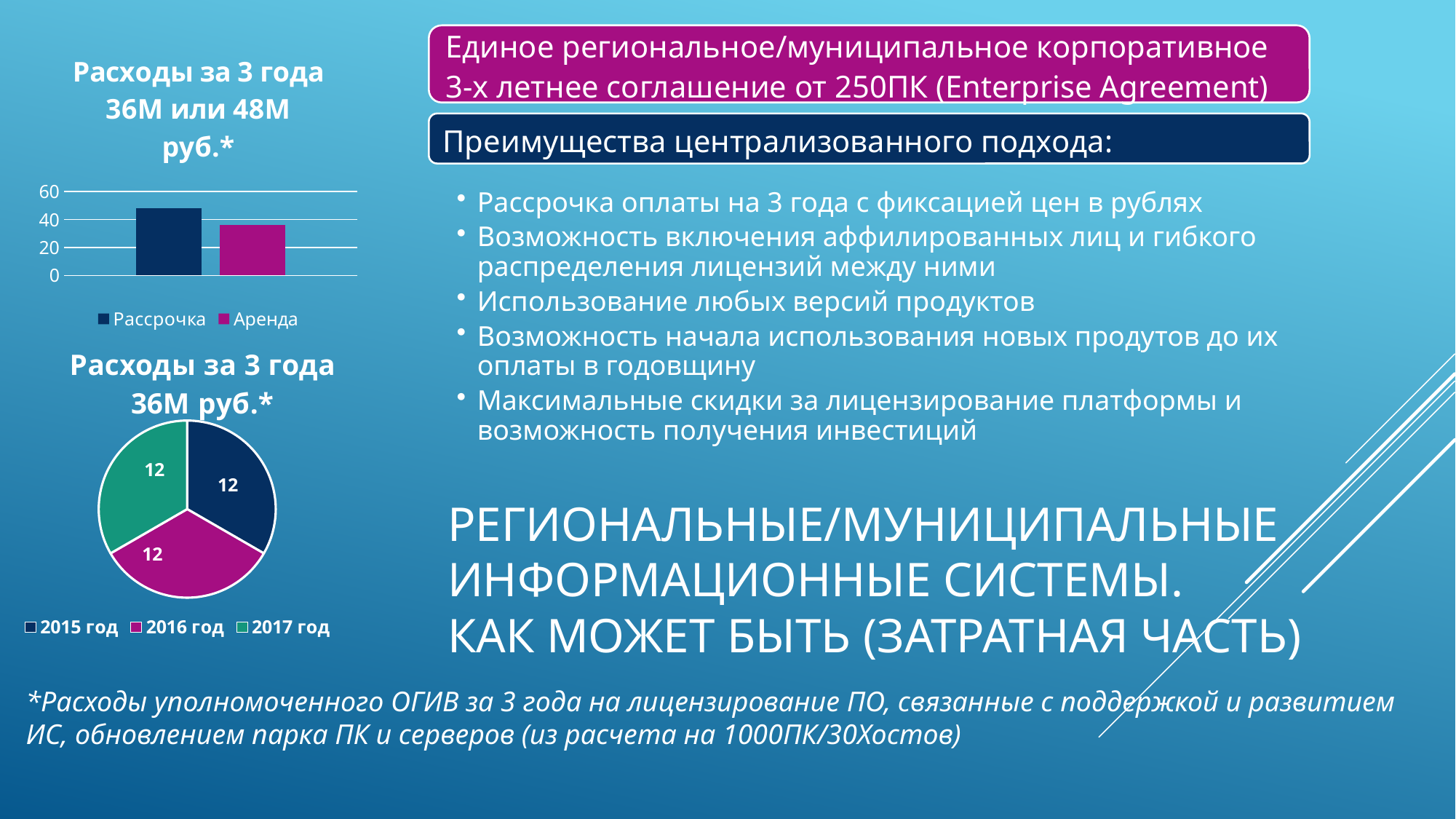
In the bar chart 'Расходы за 3 года 36М или 48М руб.*', is the value for Аренда greater or less than 40? less In the bar chart 'Расходы за 3 года 36М или 48М руб.*', is the value for Рассрочка greater or less than 40? greater In the pie chart 'Расходы за 3 года 36М руб.*', what is the value for 2016 год? 12 In the pie chart 'Расходы за 3 года 36М руб.*', what is the total of all slices? 36 What kind of chart is the bottom-left chart titled 'Расходы за 3 года 36М руб.*'? pie chart In the pie chart 'Расходы за 3 года 36М руб.*', how many slices are there? 3 In the bar chart 'Расходы за 3 года 36М или 48М руб.*', which series has the taller bar, Рассрочка or Аренда? Рассрочка In the pie chart 'Расходы за 3 года 36М руб.*', what is the value for 2017 год? 12 In the bar chart 'Расходы за 3 года 36М или 48М руб.*', how many series does the legend list? 2 What kind of chart is the top-left chart titled 'Расходы за 3 года 36М или 48М руб.*'? bar chart In the pie chart 'Расходы за 3 года 36М руб.*', what is the difference between the values for 2015 год and 2016 год? 0 In the bar chart 'Расходы за 3 года 36М или 48М руб.*', what is the highest value shown on the vertical axis? 60